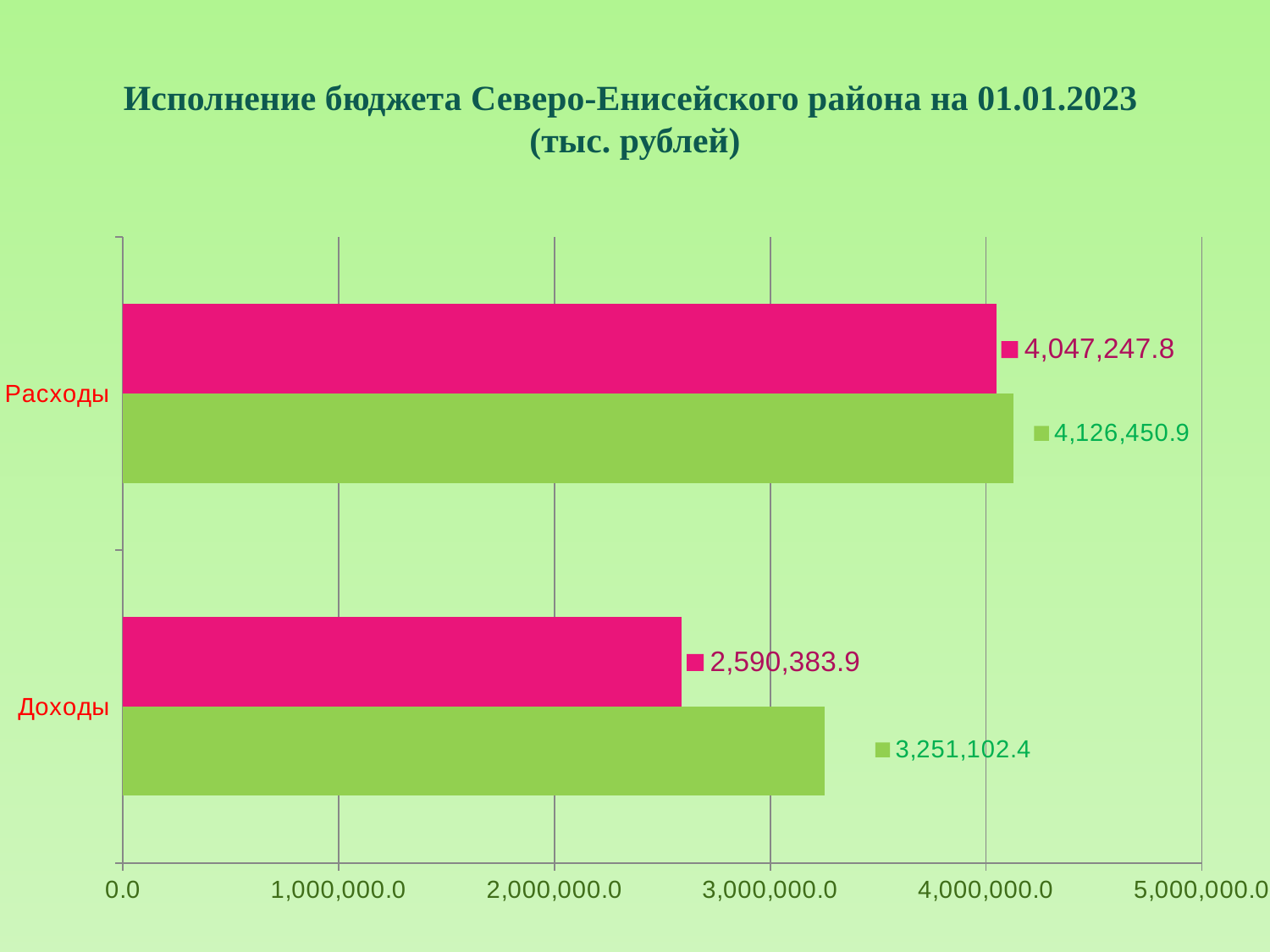
What is the value of the pink bar for Расходы? 4,047,247.8 Is the green bar for Доходы greater or less than 3,000,000.0? greater How many categories are shown on the vertical axis? 2 What type of chart is shown on the slide? Bar chart Which bar has the lowest value on the chart? Pink bar for Доходы (2,590,383.9) Which bar has the highest value on the chart? Green bar for Расходы (4,126,450.9) What is the difference between the green and pink bars for Расходы? 79,203.1 What is the value of the green bar for Доходы? 3,251,102.4 Which is larger: the pink bar for Расходы or the green bar for Доходы? Pink bar for Расходы What is the value of the pink bar for Доходы? 2,590,383.9 What is the value of the green bar for Расходы? 4,126,450.9 What is the difference between the green and pink bars for Доходы? 660,718.5